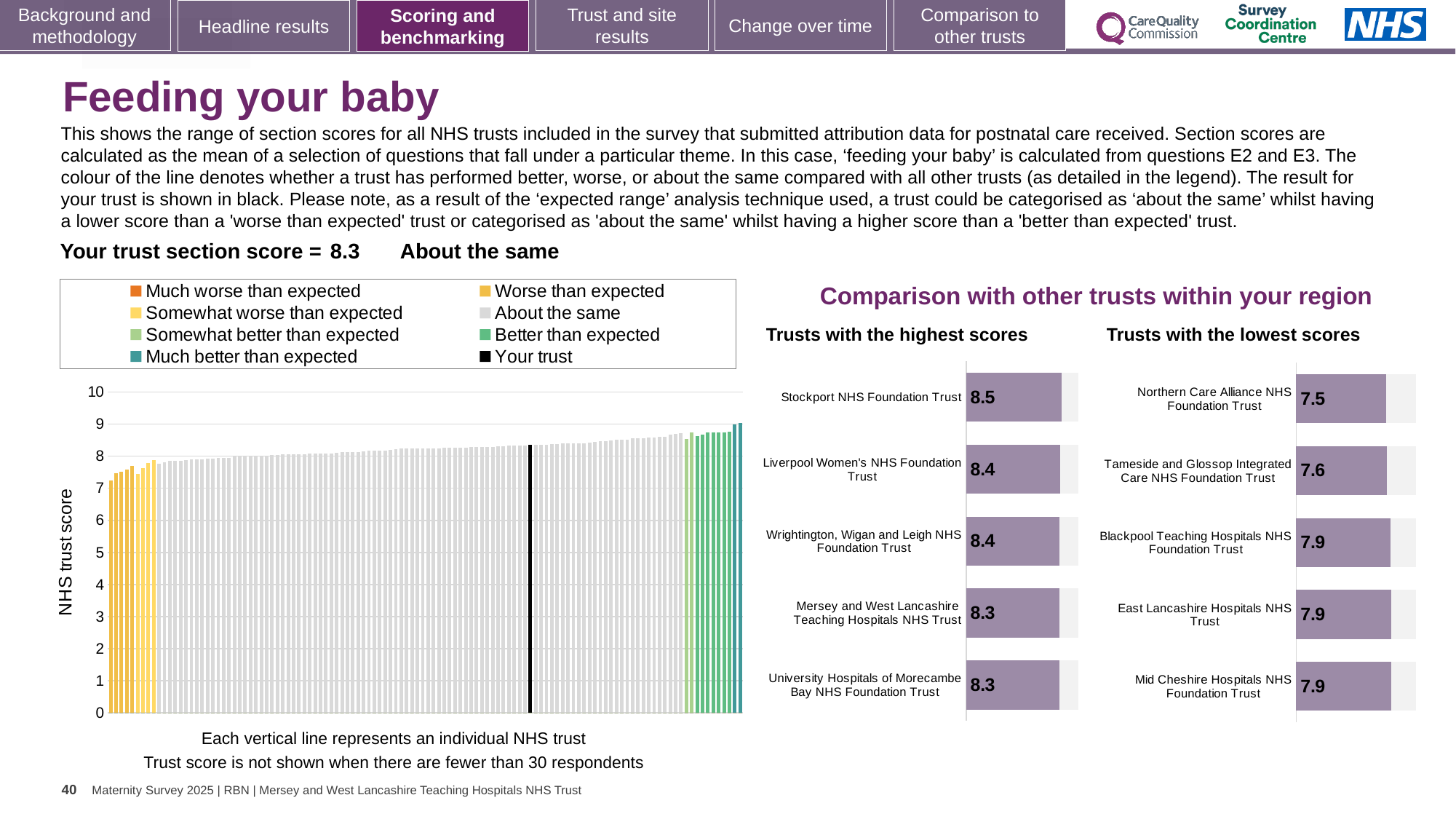
How many trusts are listed in the 'Trusts with the lowest scores' chart? 5 In the 'Trusts with the highest scores' chart, what is the score for Stockport NHS Foundation Trust? 8.5 What kind of chart is the main 'NHS trust score' chart on the left? Bar chart In the main 'NHS trust score' chart on the left, is the value of the leftmost bar greater or less than 8? less In the 'Trusts with the lowest scores' chart, what is the score for Northern Care Alliance NHS Foundation Trust? 7.5 In the 'Trusts with the lowest scores' chart, what is the difference between the scores of Tameside and Glossop Integrated Care NHS Foundation Trust and Northern Care Alliance NHS Foundation Trust? 0.1 In the main 'NHS trust score' chart on the left, do the bar values rise or fall from left to right? Rise In the main 'NHS trust score' chart on the left, how many entries does the legend list? 8 In the 'Trusts with the highest scores' chart, what is the difference between the scores of Stockport NHS Foundation Trust and University Hospitals of Morecambe Bay NHS Foundation Trust? 0.2 In the 'Trusts with the highest scores' chart, which trust has the highest score? Stockport NHS Foundation Trust Which has a higher score: Liverpool Women's NHS Foundation Trust in the 'highest scores' chart or Blackpool Teaching Hospitals NHS Foundation Trust in the 'lowest scores' chart? Liverpool Women's NHS Foundation Trust In the 'Trusts with the lowest scores' chart, which trust has the lowest score? Northern Care Alliance NHS Foundation Trust